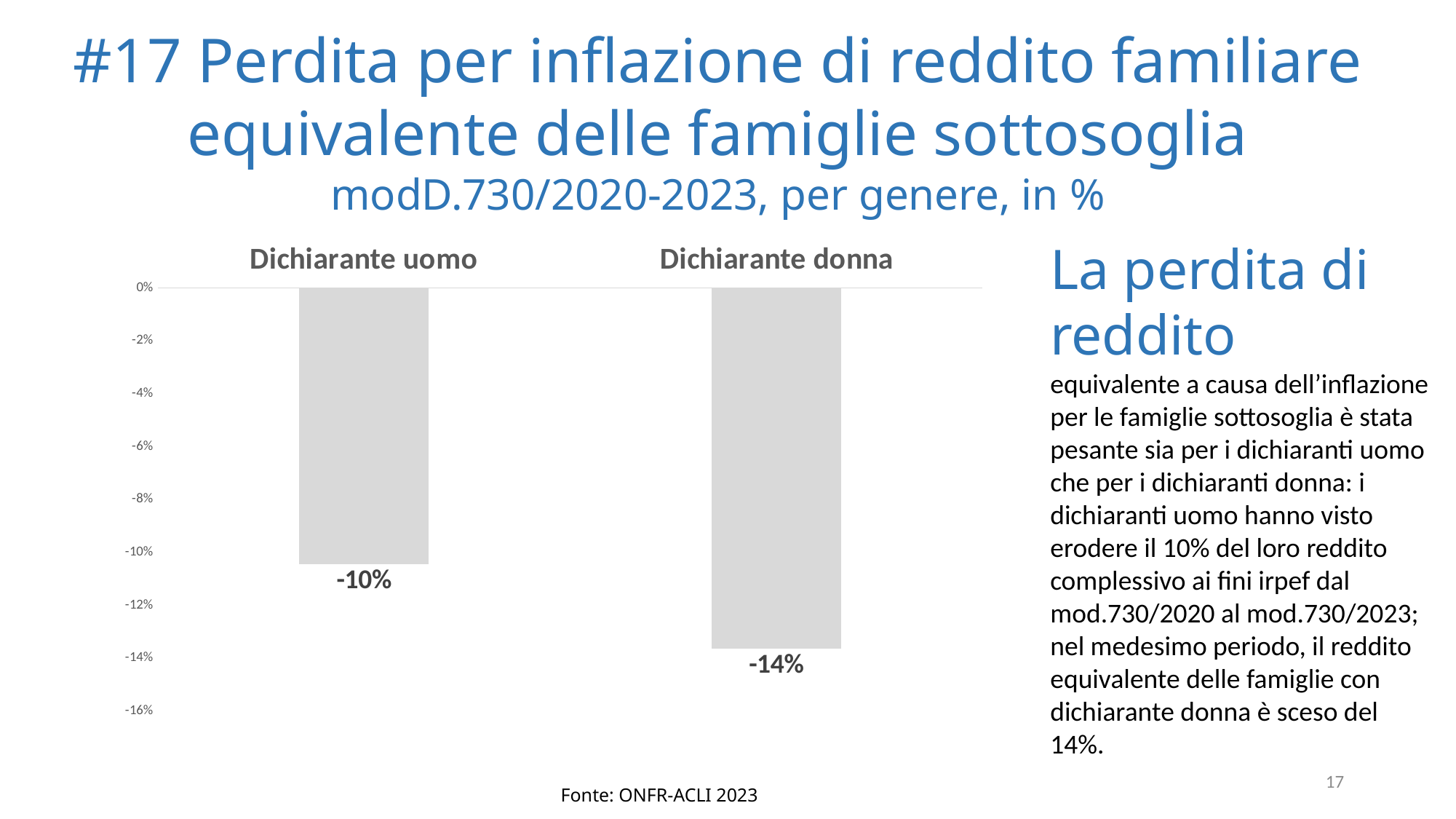
What is the difference between the values for Dichiarante uomo and Dichiarante donna? 4 percentage points Which category shows the larger loss (the lowest value)? Dichiarante donna Is the loss for Dichiarante donna larger or smaller than the loss for Dichiarante uomo? larger What is the value for Dichiarante uomo? -10% What source is cited below the chart? Fonte: ONFR-ACLI 2023 What is the value for Dichiarante donna? -14% What kind of chart is shown on the slide? bar chart Is the value for Dichiarante uomo greater or less than -12%? greater How many categories are plotted in the chart? 2 Which category has the highest value (smallest loss)? Dichiarante uomo Is the value for Dichiarante donna greater or less than -12%? less What is the lowest tick shown on the vertical axis? -16%